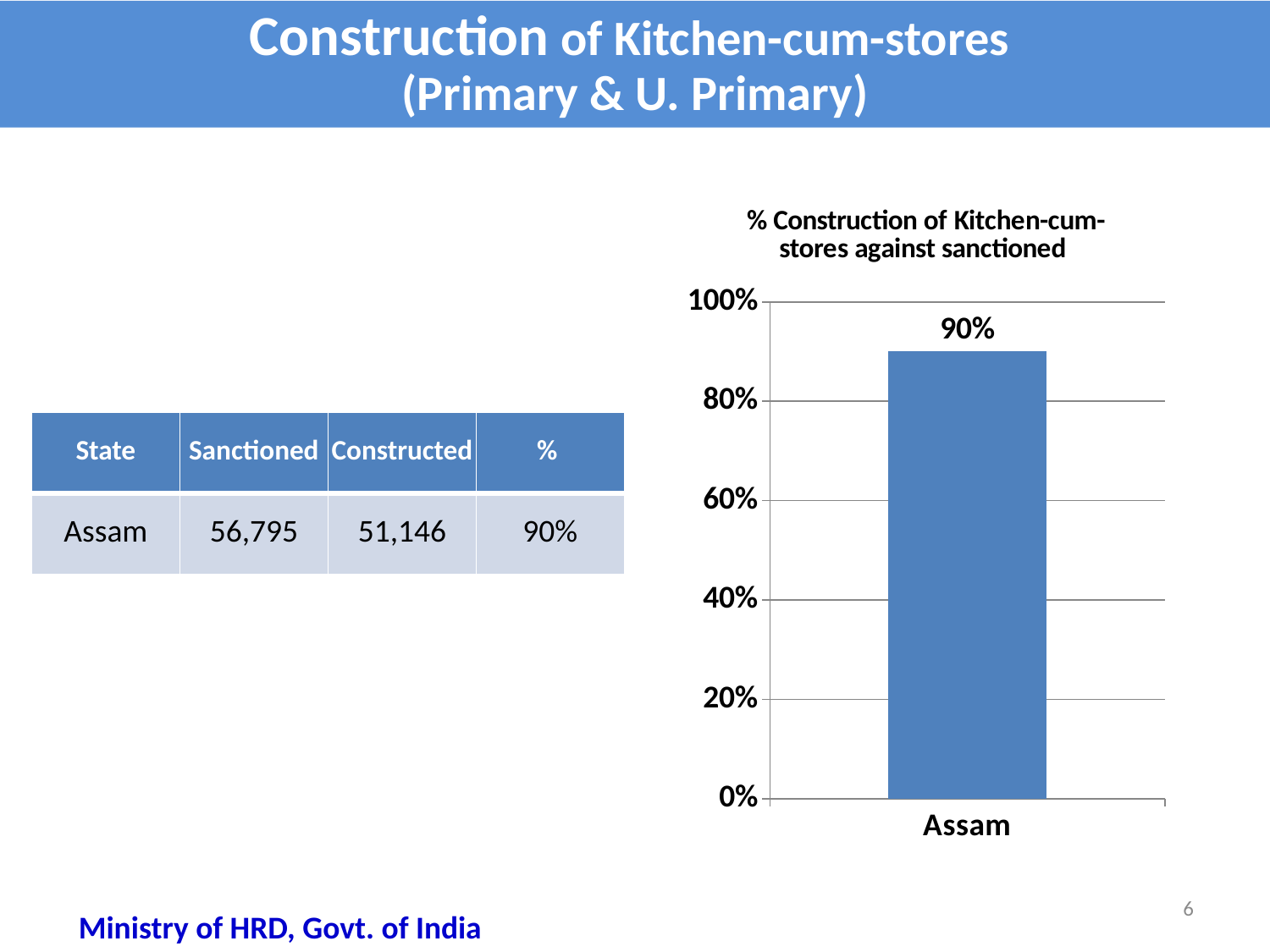
What kind of chart is shown on the slide? bar chart Is the value for Assam greater or less than 80%? greater Is the value for Assam greater or less than 100%? less What is the value for Assam in the chart? 90% How many categories are plotted in the chart? 1 What is the title of the chart? % Construction of Kitchen-cum-stores against sanctioned Which category is shown on the x axis of the chart? Assam What is the highest value shown on the chart's vertical axis? 100%